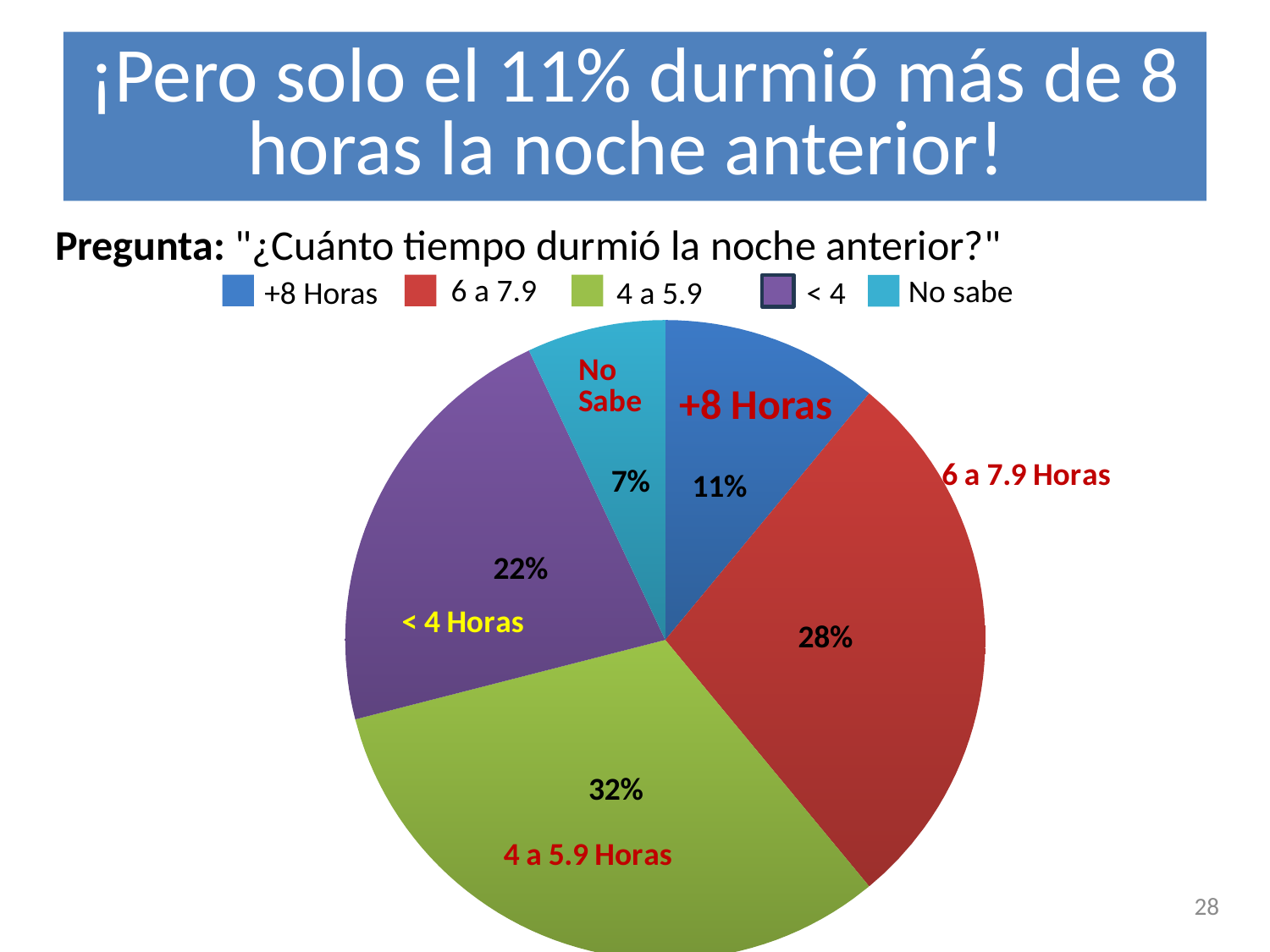
What is the difference in percentage points between the 4 a 5.9 slice and the 6 a 7.9 slice? 4 Which is larger, the share for < 4 hours or the share for +8 Horas? < 4 What percentage of respondents slept 4 a 5.9 hours? 32% Which category has the smallest share of the pie? No sabe Which category has the largest share of the pie? 4 a 5.9 What percentage of respondents slept < 4 hours? 22% What percentage of respondents slept +8 Horas? 11% What percentage of respondents slept 6 a 7.9 hours? 28% How many categories does the legend list? 5 What colour is the slice for 6 a 7.9 hours? red What percentage of respondents answered No sabe? 7% What kind of chart is shown on the slide? pie chart